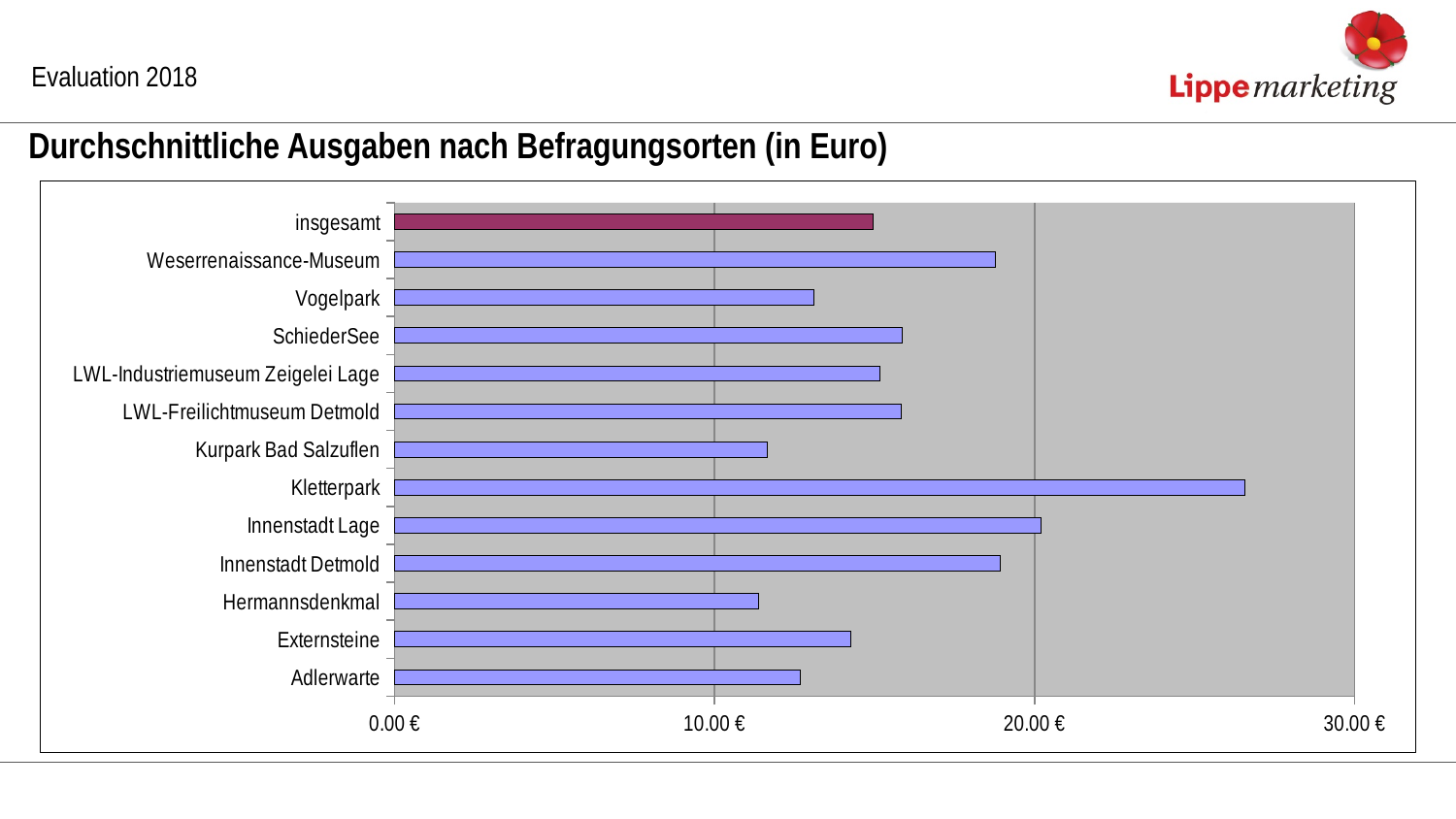
Which is larger, the value for Externsteine or the value for Adlerwarte? Externsteine Is the value for Adlerwarte greater or less than 20.00 €? less Is the value for insgesamt greater or less than 10.00 €? greater Which category has the highest average spending? Kletterpark Which is larger, the value for Kletterpark or the value for insgesamt? Kletterpark What is the title of the chart? Durchschnittliche Ausgaben nach Befragungsorten (in Euro) How many categories are plotted on the chart? 13 Which is larger, the value for Weserrenaissance-Museum or the value for Vogelpark? Weserrenaissance-Museum Is the value for Weserrenaissance-Museum greater or less than 20.00 €? less What kind of chart is shown on the slide? bar chart